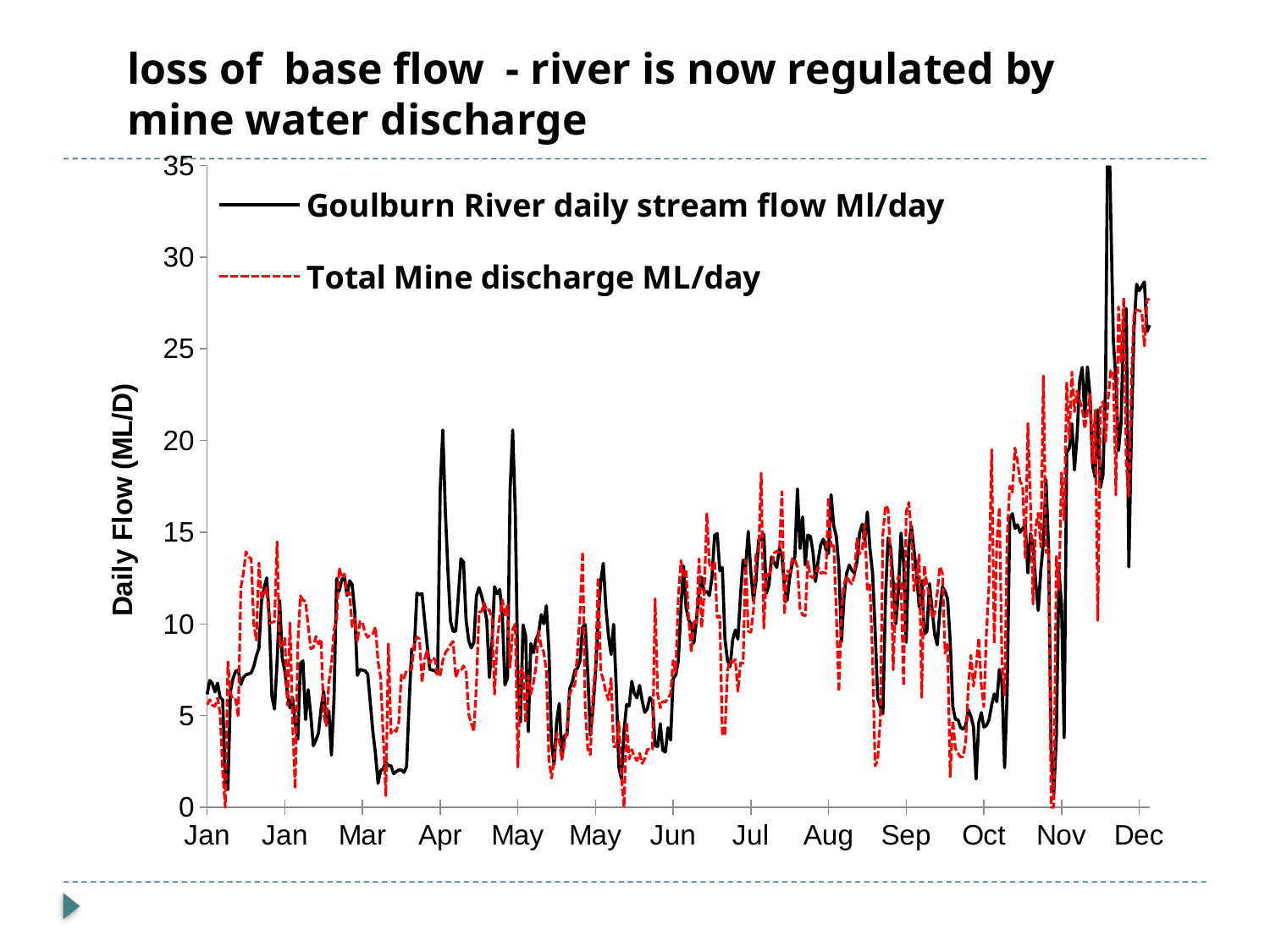
What kind of chart is shown on the slide? line chart Overall, do the Goulburn River daily stream flow values rise or fall from January to December? rise Is the Goulburn River daily stream flow at the end of the series in December greater or less than 20? greater Is the Goulburn River daily stream flow at the start of January greater or less than 10? less Is the highest peak of the Total Mine discharge series greater or less than 30? less What is the title of the vertical axis? Daily Flow (ML/D) How many series does the legend list? 2 Overall, do the Total Mine discharge values rise or fall from January to December? rise Which series is drawn as a red dashed line? Total Mine discharge ML/day Which series reaches the higher maximum value, Goulburn River daily stream flow or Total Mine discharge? Goulburn River daily stream flow Ml/day What is the highest value shown on the vertical axis? 35